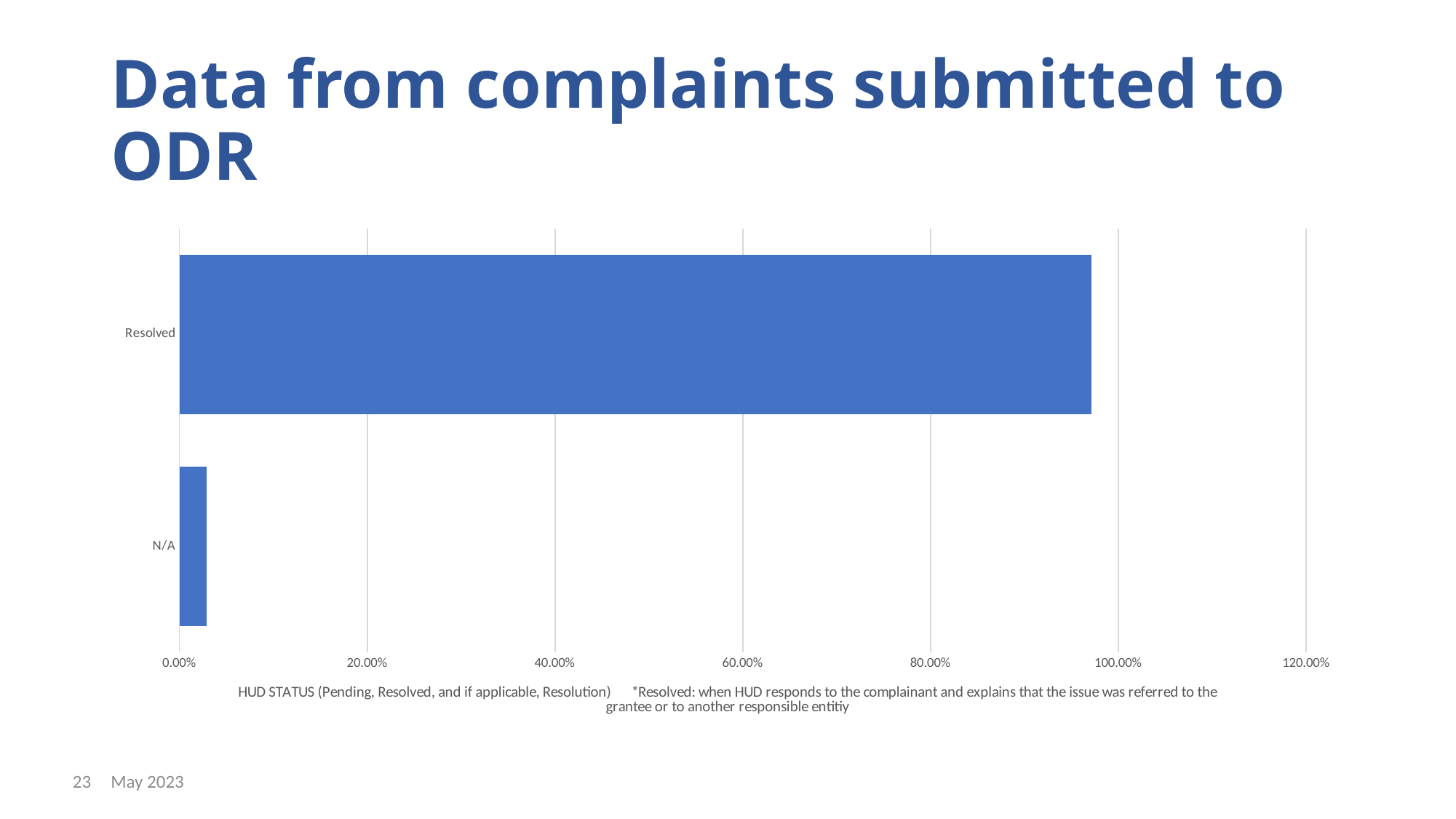
Which category has the lowest value? N/A Is the value for Resolved greater or less than 100.00%? less Which is larger, the value for Resolved or the value for N/A? Resolved What kind of chart is shown on the slide? bar chart Which category has the highest value? Resolved What is the title of the slide? Data from complaints submitted to ODR Is the value for N/A greater or less than 20.00%? less What is the highest tick label shown on the horizontal axis? 120.00% How many categories are plotted in the chart? 2 Is the value for Resolved greater or less than 80.00%? greater